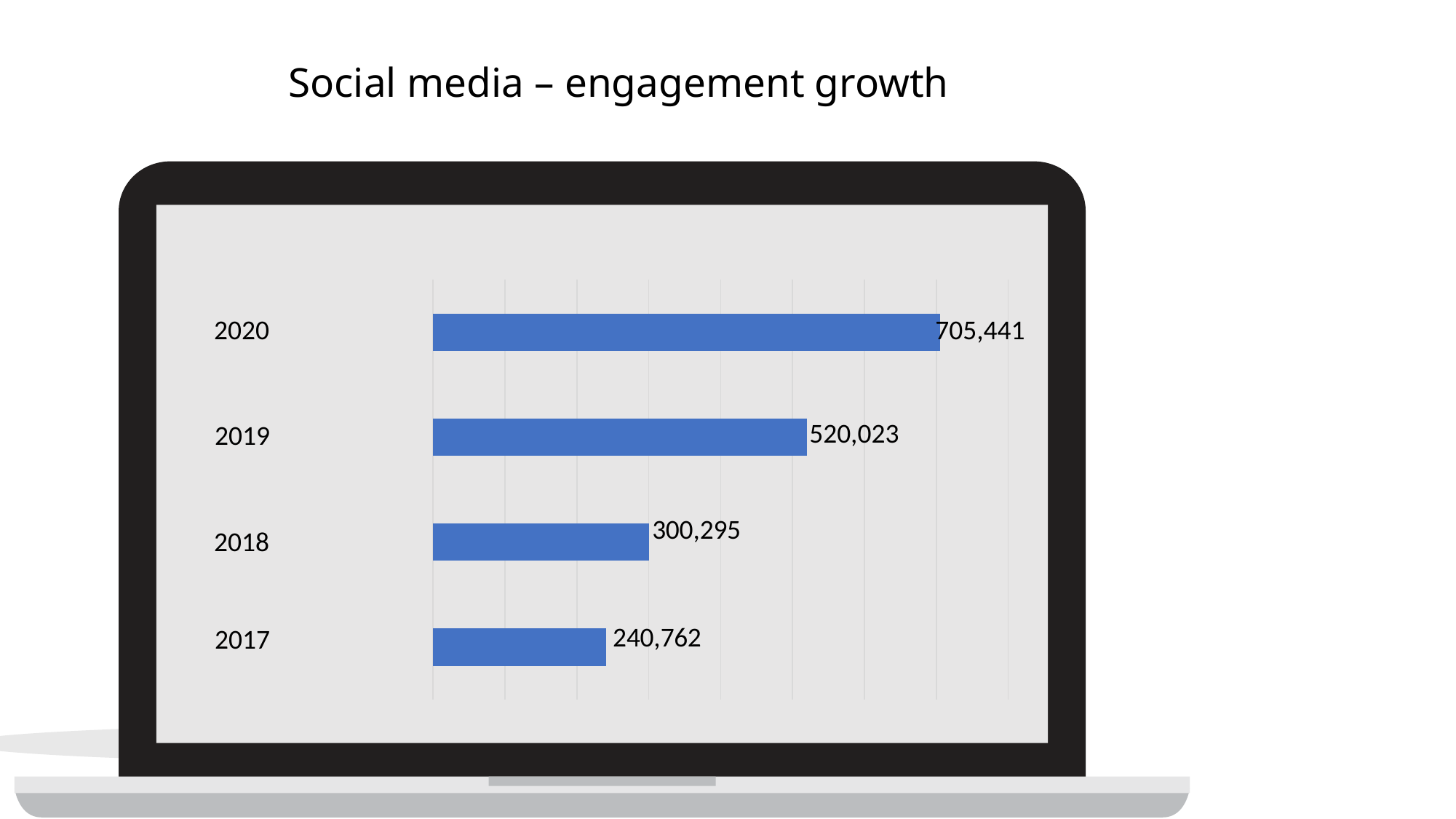
What is the value for 2019? 520,023 What is the title of the slide? Social media – engagement growth What is the difference between the values for 2020 and 2019? 185,418 How many years are shown in the chart? 4 What is the value for 2017? 240,762 Which year has the lowest value? 2017 Which is larger, the value for 2019 or the value for 2018? 2019 What is the difference between the values for 2018 and 2017? 59,533 What kind of chart is shown on the slide? Bar chart What is the value for 2018? 300,295 Which year has the highest value? 2020 What is the value for 2020? 705,441